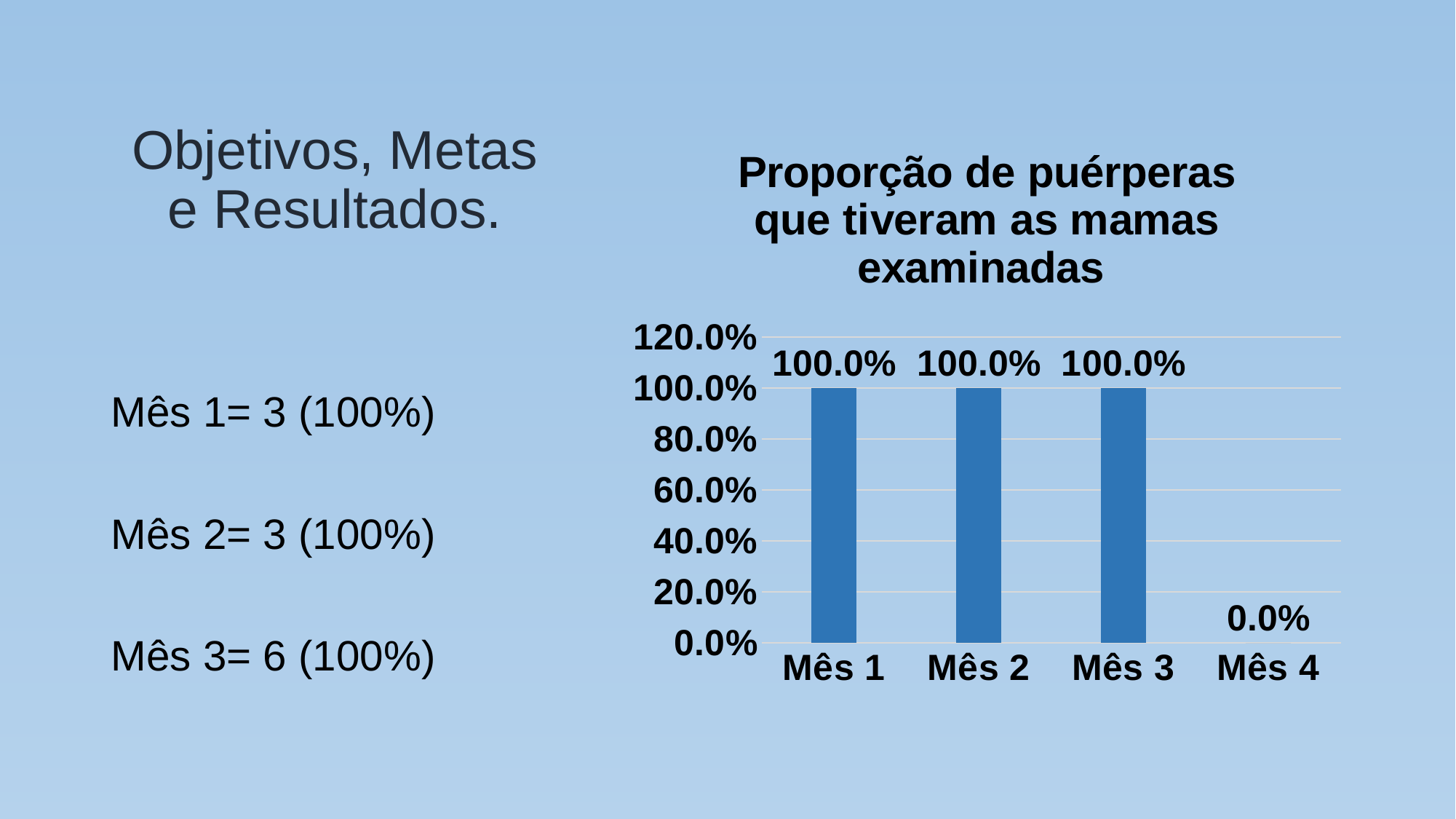
What is the title of the chart? Proporção de puérperas que tiveram as mamas examinadas Which is larger, the value for Mês 3 or the value for Mês 4? Mês 3 What is the difference between the values for Mês 2 and Mês 4? 100.0% How many categories are shown on the x axis? 4 Is the value for Mês 2 greater or less than 80.0%? greater Which category has the lowest value? Mês 4 What is the value for Mês 4? 0.0% What is the value for Mês 1? 100.0% How many categories have a value of 100.0%? 3 What kind of chart is shown on the slide? bar chart What is the highest value shown on the y axis? 120.0% What is the value for Mês 3? 100.0%